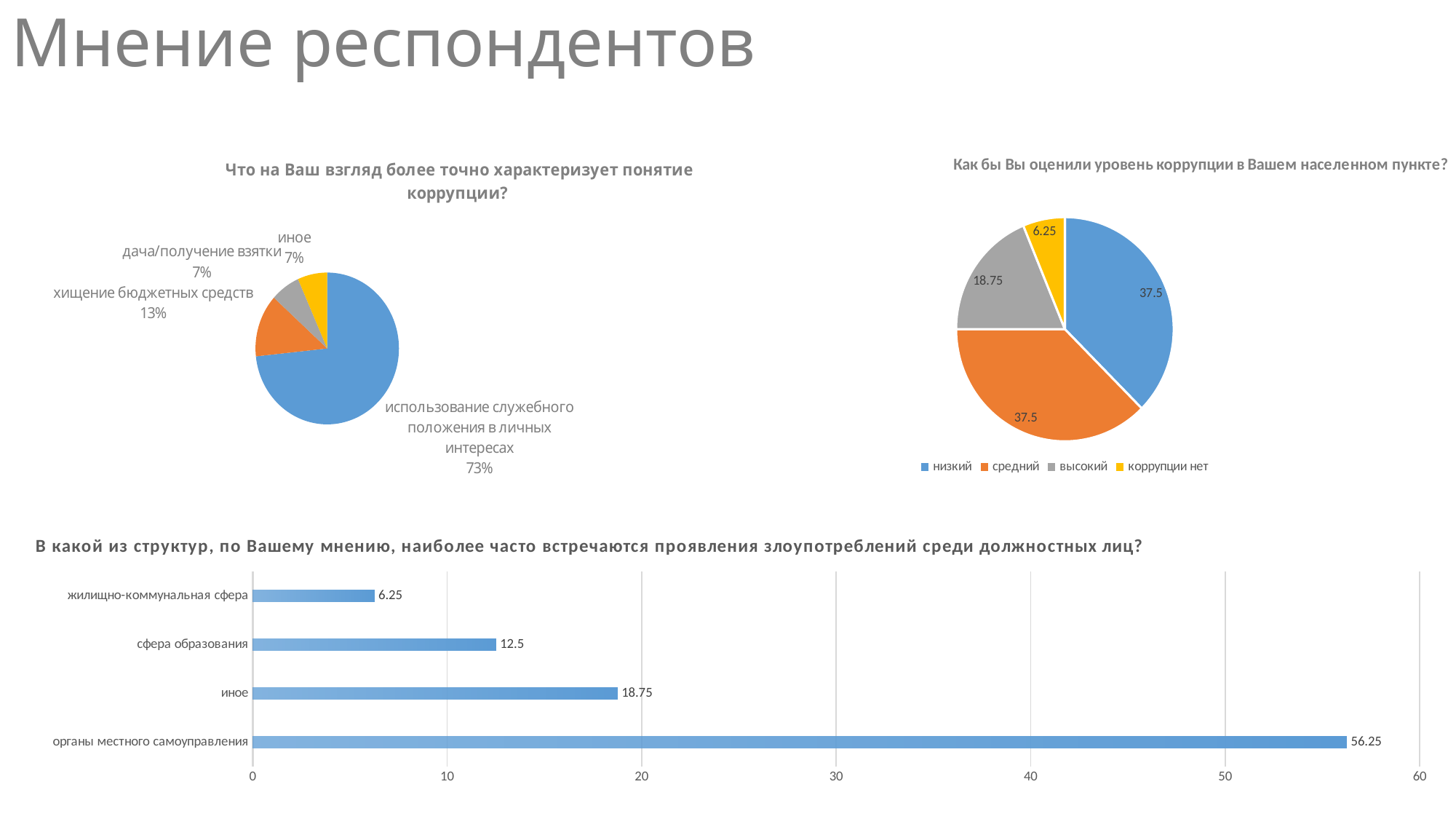
In the top-left pie chart, which slice is the largest? использование служебного положения в личных интересах In the top-right pie chart, which category has the smallest slice? коррупции нет In the top-left pie chart 'Что на Ваш взгляд более точно характеризует понятие коррупции?', what share does 'использование служебного положения в личных интересах' have? 73% How many entries does the legend of the top-right pie chart list? 4 In the bottom bar chart, what is the difference between the values for 'органы местного самоуправления' and 'иное'? 37.5 In the bottom bar chart, how many categories are shown? 4 In the bottom bar chart, which category has the lowest value? жилищно-коммунальная сфера In the top-left pie chart, what share does 'хищение бюджетных средств' have? 13% In the bottom bar chart 'В какой из структур, по Вашему мнению, наиболее часто встречаются проявления злоупотреблений среди должностных лиц?', what is the value for 'органы местного самоуправления'? 56.25 In the bottom bar chart, what is the value for 'сфера образования'? 12.5 In the top-right pie chart 'Как бы Вы оценили уровень коррупции в Вашем населенном пункте?', what is the value for 'высокий'? 18.75 What type of chart is the bottom chart on the slide? bar chart